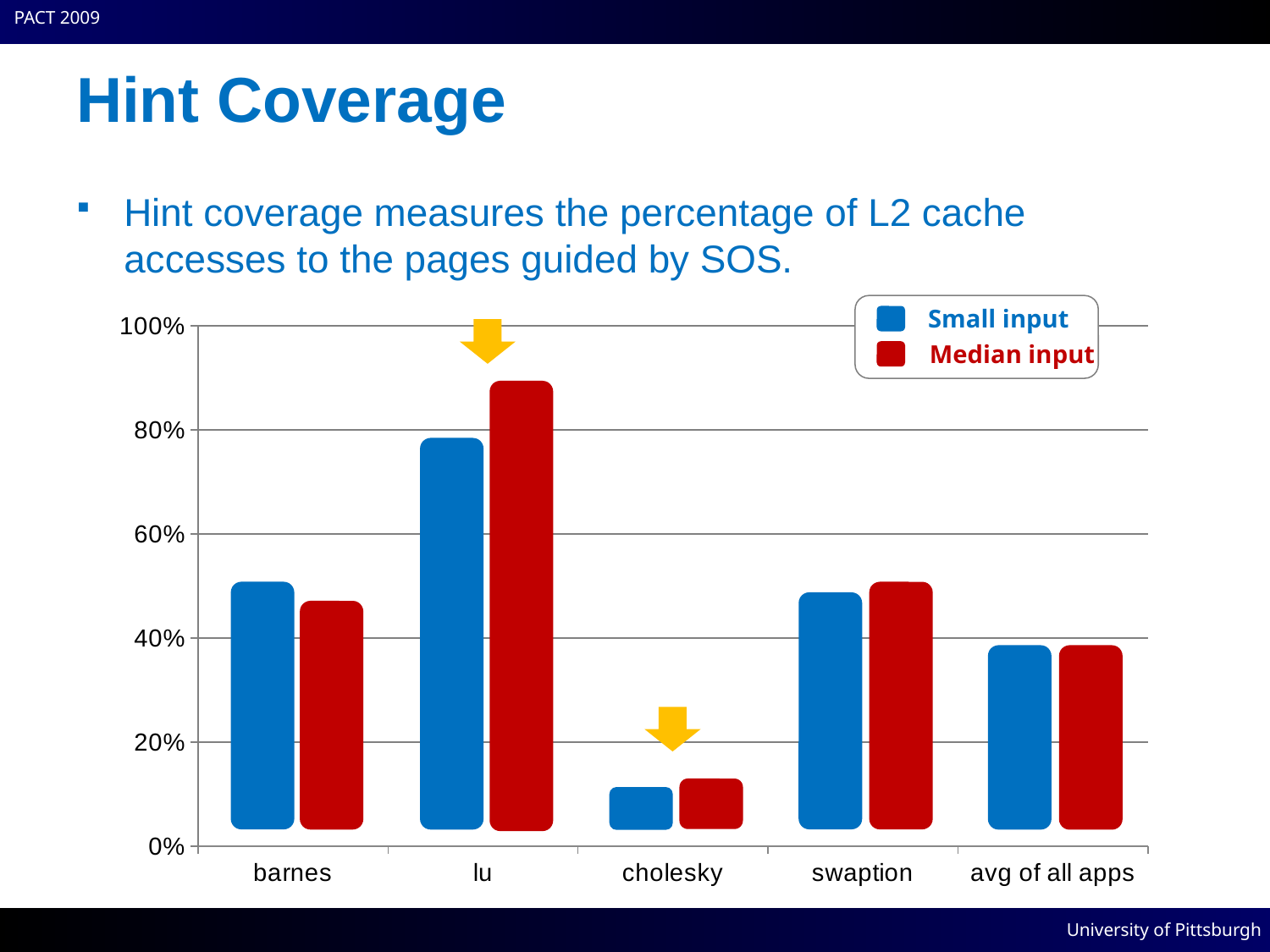
Is the Small input value for cholesky greater or less than 20%? less Which category has the highest Median input value? lu What are the two legend entries of the chart? Small input, Median input Is the Median input value for lu greater or less than 80%? greater Is the Small input value for barnes greater or less than 40%? greater Which category has the lowest Small input value? cholesky How many series does the legend list? 2 For barnes, which is larger: the Small input value or the Median input value? Small input Which category has the highest Small input value? lu What kind of chart is shown on the slide? bar chart For lu, which is larger: the Small input value or the Median input value? Median input How many categories are shown on the x axis? 5